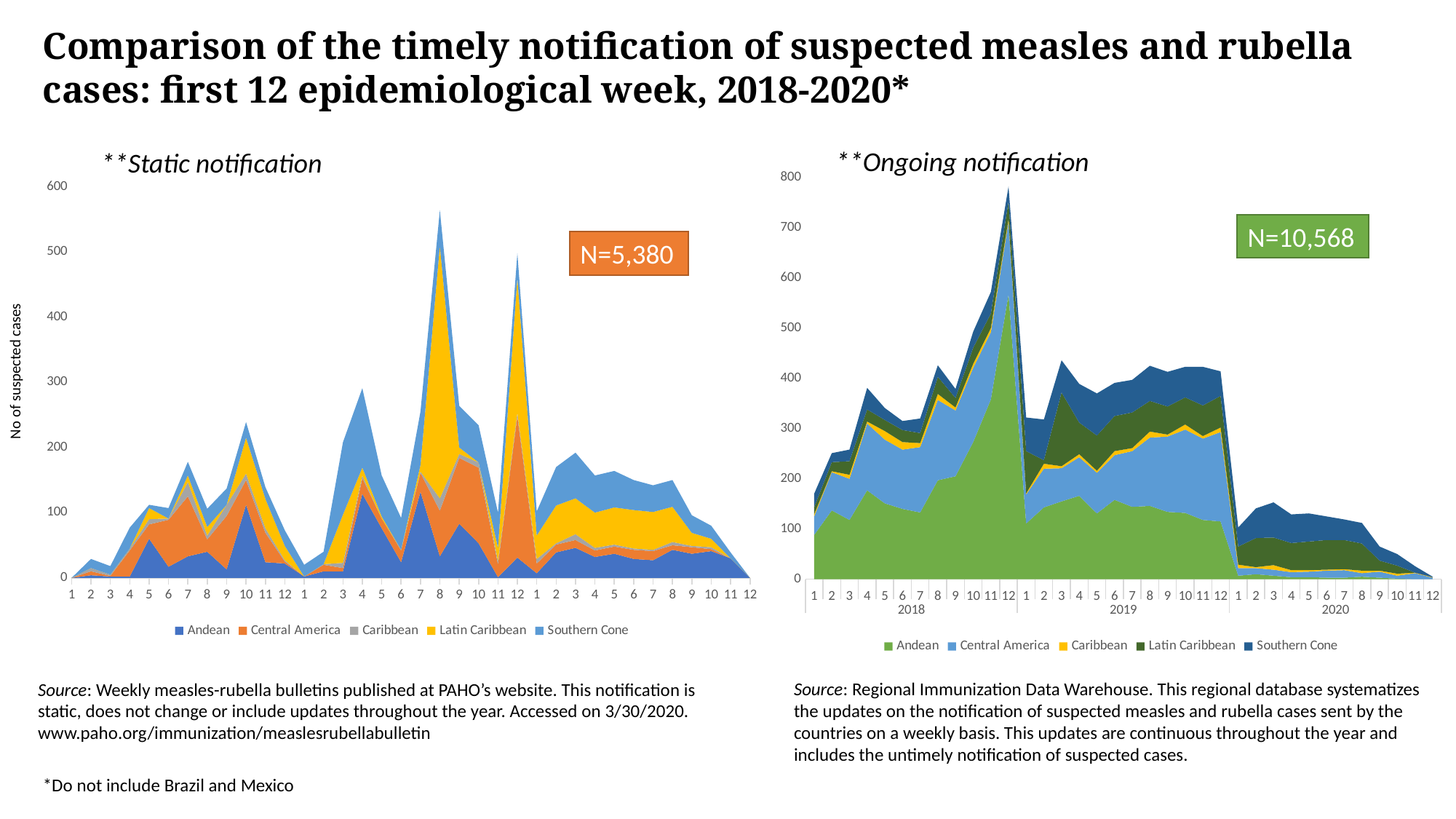
In the "Ongoing notification" chart, is the total value at week 1 of 2020 greater or less than 200? less How many weekly data points are plotted along the x axis of the "Ongoing notification" chart? 36 What is the N value shown on the "Ongoing notification" chart? N=10,568 How many series does the legend of the "Ongoing notification" chart list? 5 In the "Static notification" chart, which week has the highest total number of suspected cases? Week 8 of 2019 In the "Ongoing notification" chart, which is larger: the total at week 12 of 2018 or the total at week 1 of 2020? Week 12 of 2018 What kind of chart is the "Static notification" chart on the left? Stacked area chart In the "Ongoing notification" chart, which week has the highest total number of suspected cases? Week 12 of 2018 What is the N value shown on the "Static notification" chart? N=5,380 In the "Ongoing notification" chart, is the total value at week 12 of 2018 greater or less than 700? greater In the "Static notification" chart, is the total value at week 8 of 2019 greater or less than 500? greater What is the y-axis label of the "Static notification" chart? No of suspected cases